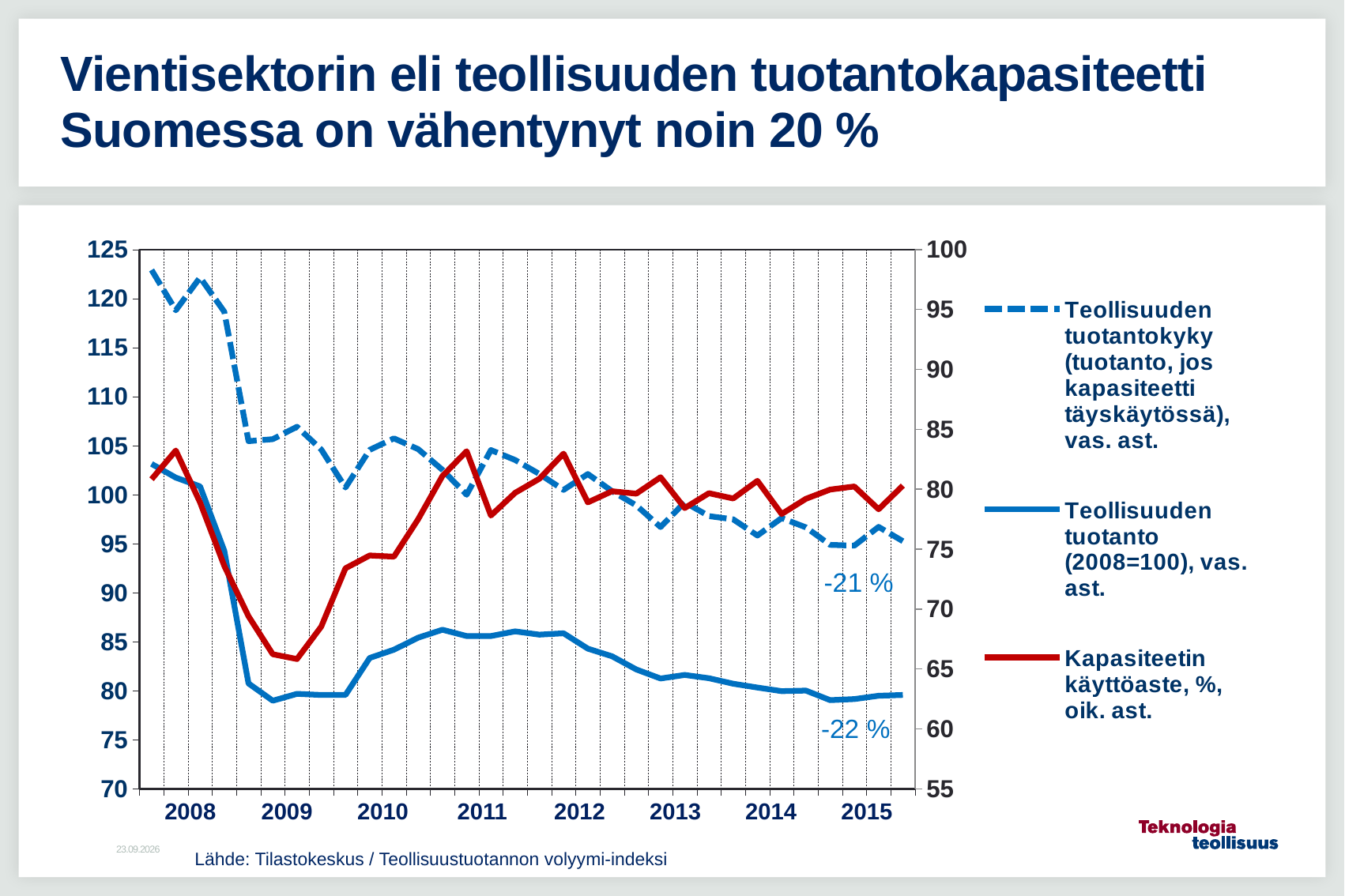
What percentage change is annotated on the chart for the Teollisuuden tuotanto series? -22 % Does the Teollisuuden tuotanto (2008=100) series rise or fall between 2008 and 2015? fall What kind of chart is shown on the slide? line chart Is the value of Teollisuuden tuotanto in 2015 greater or less than 85? less Which series is plotted on the right-hand axis (oik. ast.)? Kapasiteetin käyttöaste, % In which year does the Kapasiteetin käyttöaste series reach its lowest point? 2009 Is the lowest value of Kapasiteetin käyttöaste in 2009 greater or less than 70 on the right axis? less Is the value of Teollisuuden tuotantokyky at the start of 2008 greater or less than 120? greater What percentage change is annotated on the chart for the Teollisuuden tuotantokyky series? -21 % In 2015, which is higher: Teollisuuden tuotantokyky or Teollisuuden tuotanto? Teollisuuden tuotantokyky How many series does the legend list? 3 How many year labels are shown on the x axis? 8